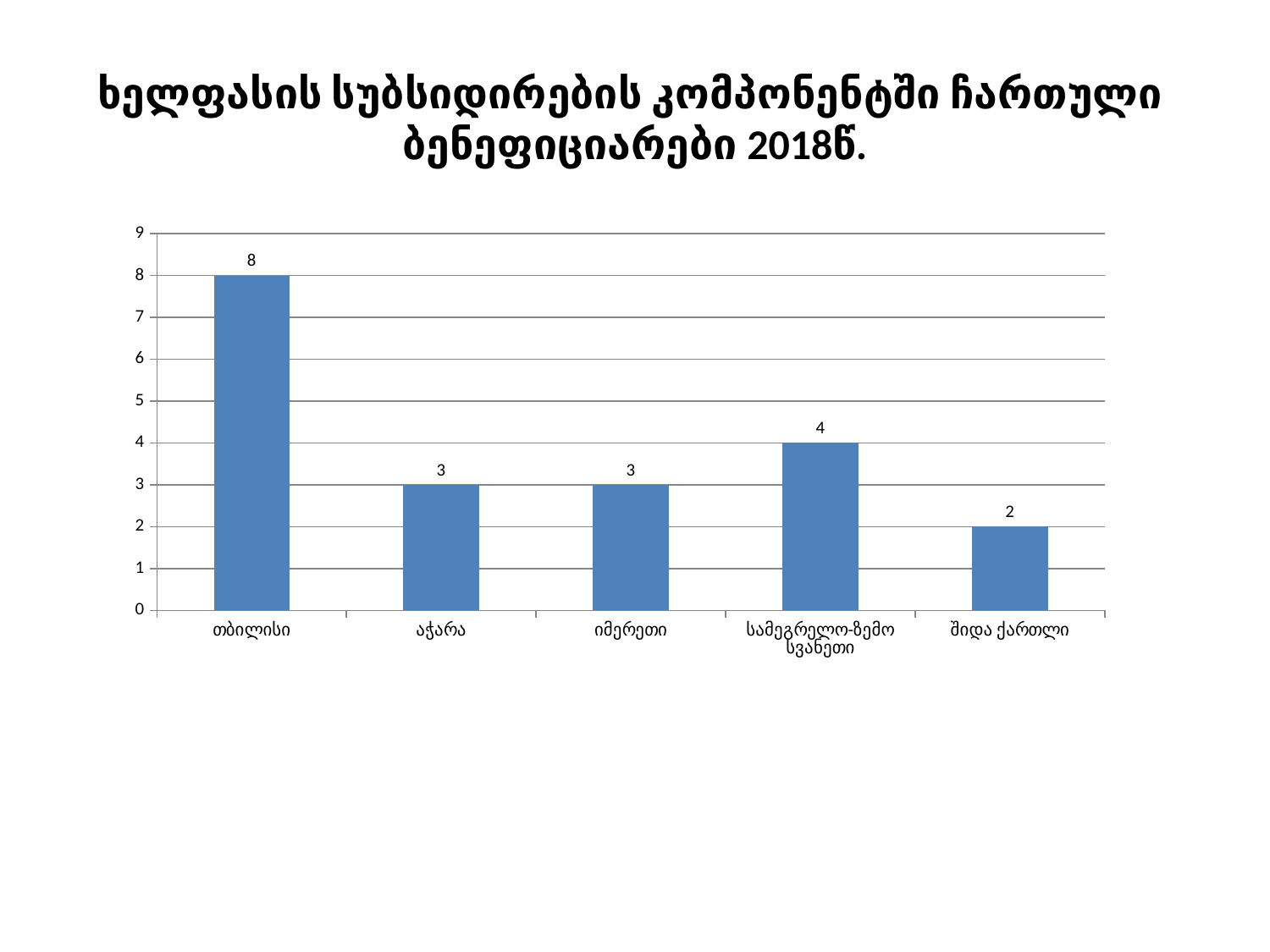
What year is mentioned in the chart title? 2018 What kind of chart is shown on the slide? bar chart What is the value for სამეგრელო-ზემო სვანეთი? 4 Which category has the lowest value? შიდა ქართლი What is the value for შიდა ქართლი? 2 How many categories are shown on the x axis? 5 Which category has the highest value? თბილისი What is the value for აჭარა? 3 Which is larger, the value for სამეგრელო-ზემო სვანეთი or the value for იმერეთი? სამეგრელო-ზემო სვანეთი What is the difference between the values for თბილისი and სამეგრელო-ზემო სვანეთი? 4 Is the value for თბილისი greater or less than 5? greater What is the value for თბილისი? 8